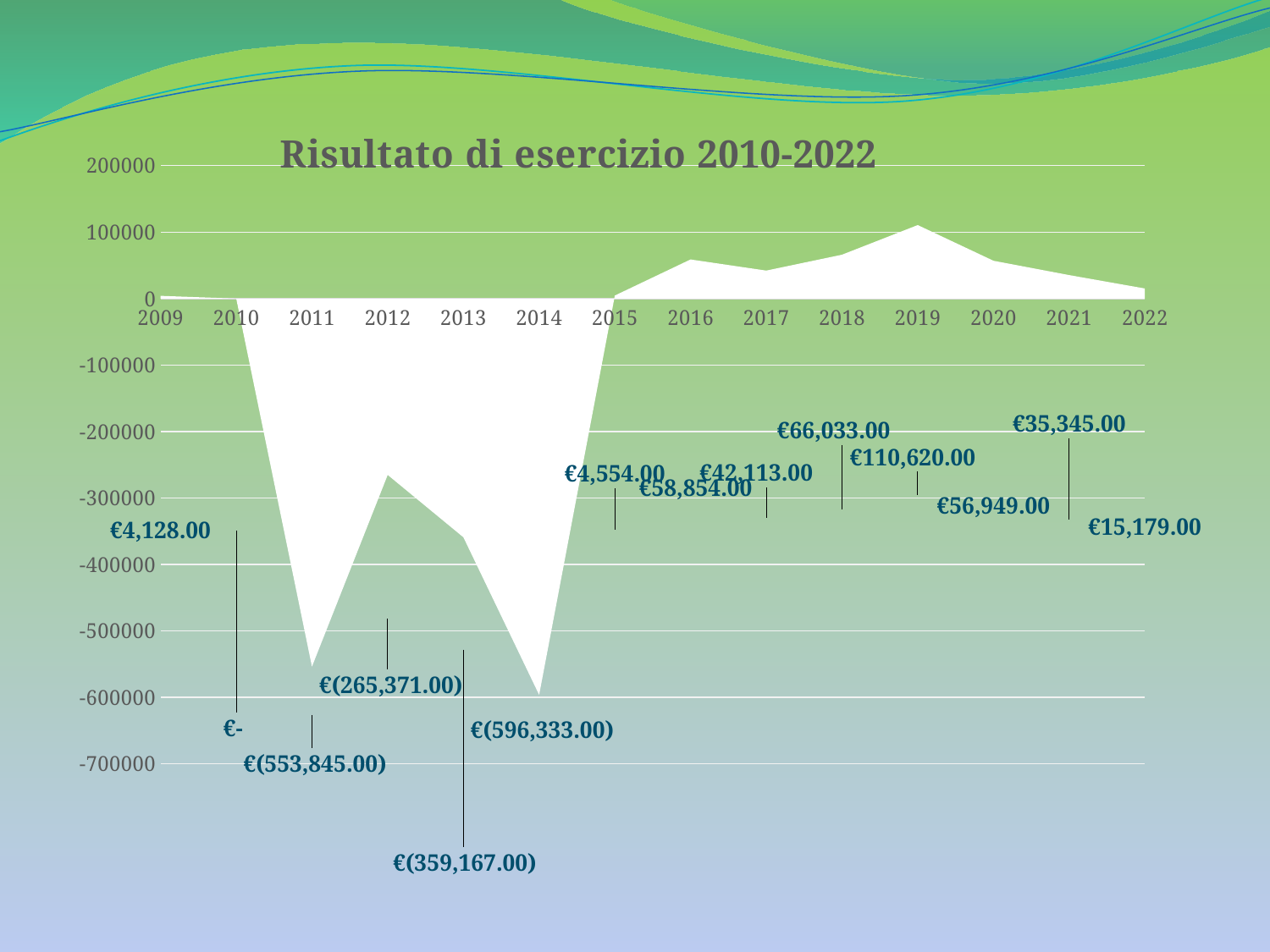
What is the value for 2011? €(553,845.00) What is the value for 2022? €15,179.00 Which year has the lowest value in the chart? 2014 What is the value for 2012? €(265,371.00) How many years are shown on the x axis of the chart? 14 Do the values rise or fall from 2019 to 2022? Fall Which is larger, the value for 2016 or the value for 2017? 2016 What is the title of the chart? Risultato di esercizio 2010-2022 What kind of chart is shown on the slide? Area chart Which year has the highest value in the chart? 2019 What is the difference between the values for 2019 and 2020? €53,671.00 What is the value for 2019? €110,620.00